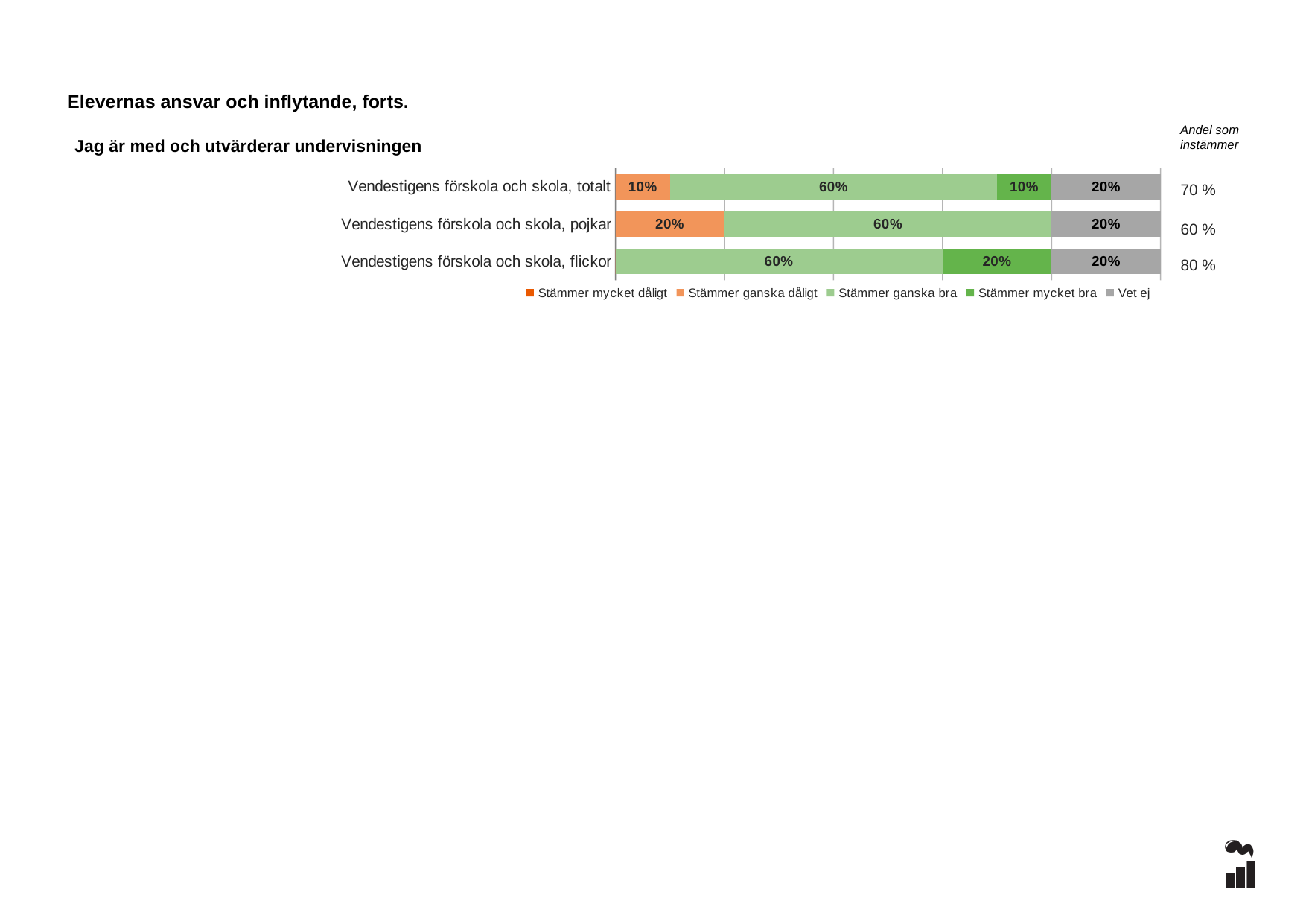
How many categories (rows) does the chart show? 3 How many series does the legend list? 5 What is the difference between the "Stämmer mycket bra" values for "Vendestigens förskola och skola, flickor" and "Vendestigens förskola och skola, totalt"? 10% Which category has the highest "Andel som instämmer" value? Vendestigens förskola och skola, flickor What is the title of the chart? Jag är med och utvärderar undervisningen What is the value of "Stämmer ganska dåligt" for "Vendestigens förskola och skola, pojkar"? 20% What is the value of "Stämmer mycket bra" for "Vendestigens förskola och skola, flickor"? 20% What is the value of "Stämmer ganska bra" for "Vendestigens förskola och skola, totalt"? 60% What is the value of "Vet ej" for "Vendestigens förskola och skola, totalt"? 20% Which category has the lowest "Andel som instämmer" value? Vendestigens förskola och skola, pojkar What is the "Andel som instämmer" value shown for "Vendestigens förskola och skola, flickor"? 80 % What kind of chart is shown on the slide? Stacked bar chart